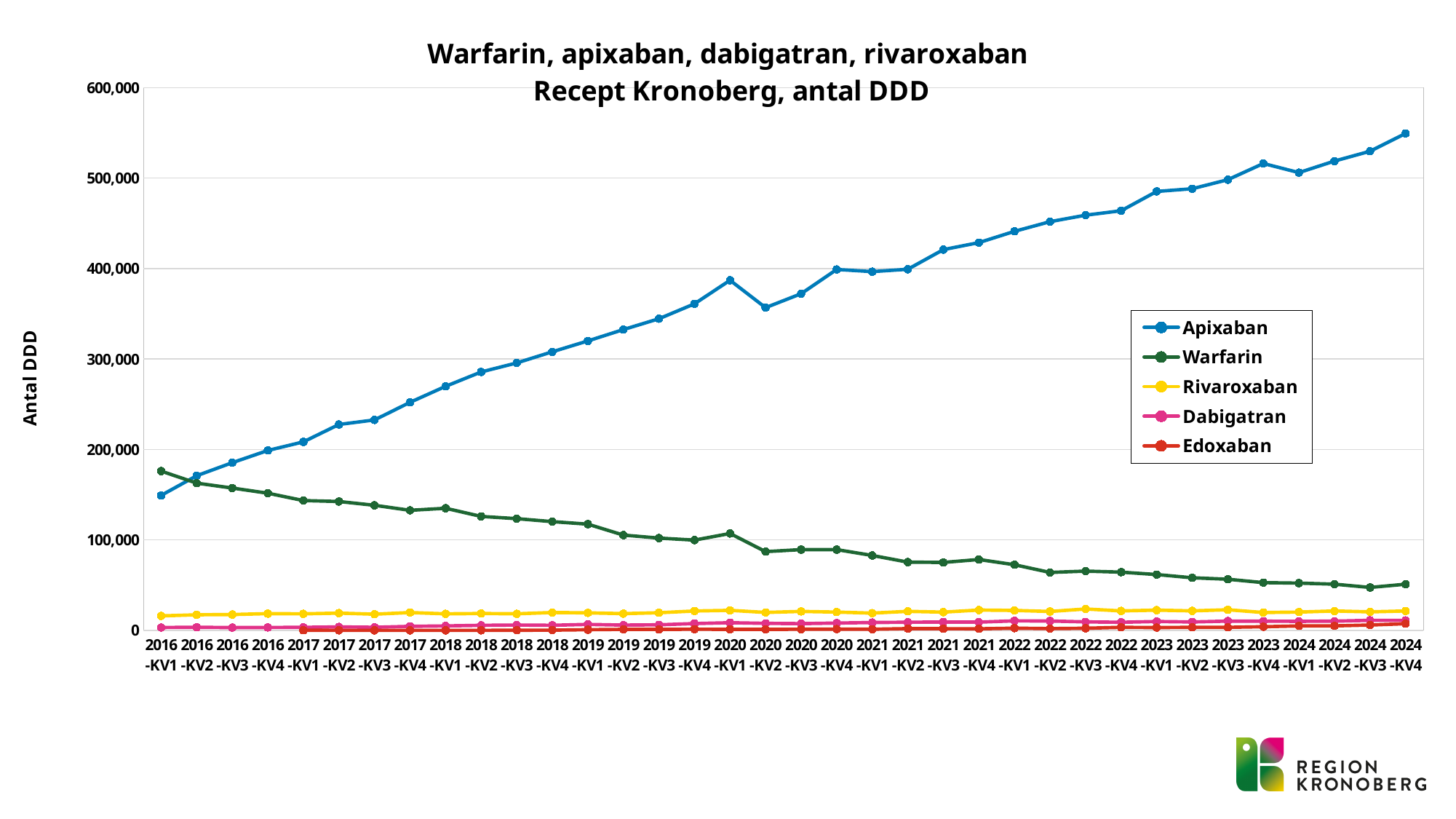
How many series does the legend list? 5 At 2016-KV1, which is larger: Warfarin or Apixaban? Warfarin What is the label on the y axis? Antal DDD Does the Warfarin line rise or fall from 2016-KV1 to 2024-KV4? fall Is the value for Warfarin at 2024-KV4 greater or less than 100,000? less Is the value for Apixaban at 2024-KV4 greater or less than 500,000? greater Which series is shown in yellow in the legend? Rivaroxaban How many quarterly points are plotted along the x axis? 36 Is the value for Apixaban at 2020-KV1 greater or less than 350,000? greater Which series has the highest value at 2024-KV4? Apixaban Does the Apixaban line rise or fall from 2016-KV1 to 2024-KV4? rise What kind of chart is shown on the slide? line chart